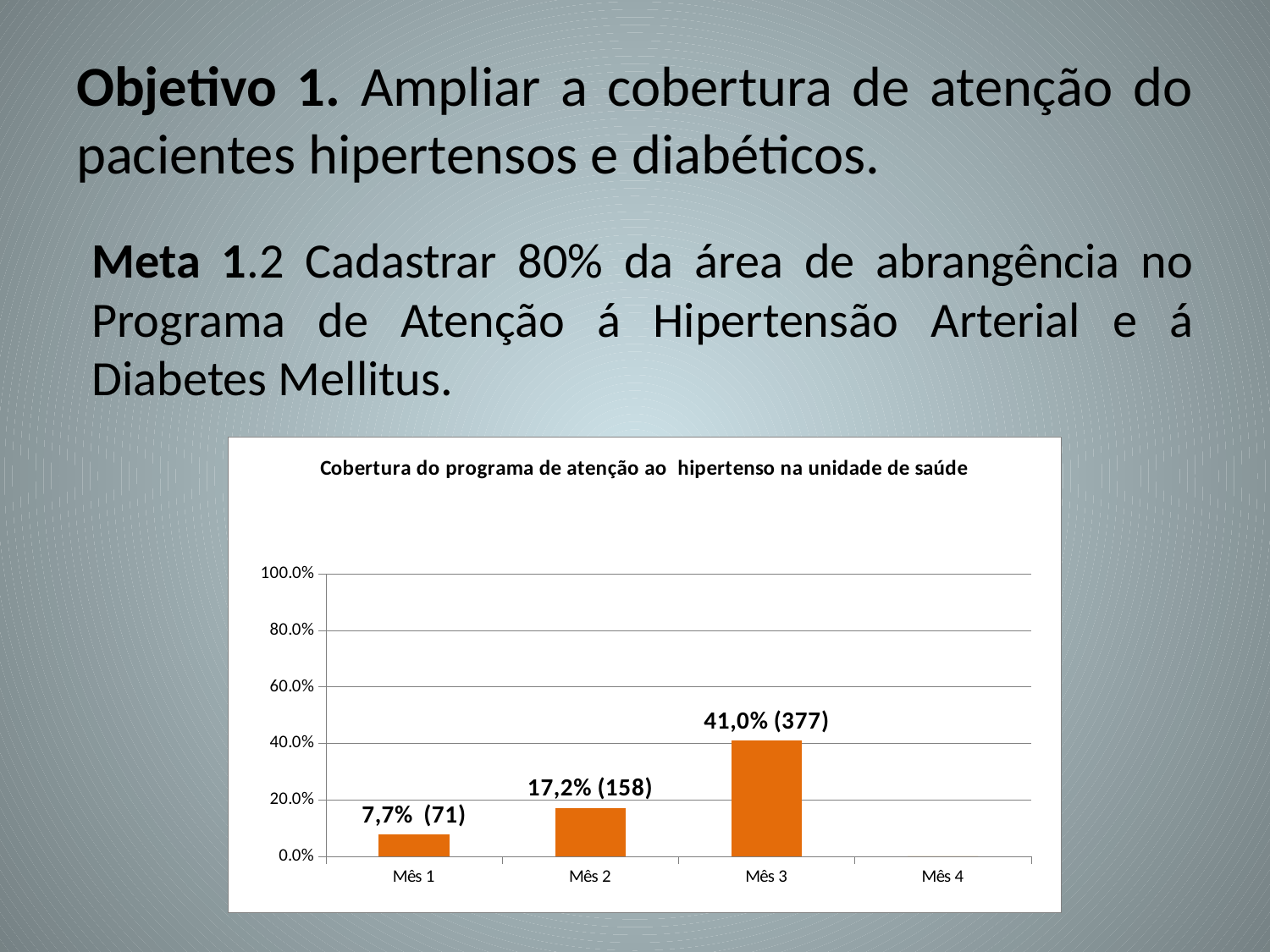
Which is larger, the value for Mês 2 or the value for Mês 1? Mês 2 Which month has the highest coverage in the chart? Mês 3 Do the values rise or fall from Mês 1 to Mês 3? rise What is the value shown for Mês 2? 17,2% (158) What kind of chart is shown on the slide? bar chart What is the value shown for Mês 1? 7,7% (71) How many month categories are shown on the x axis? 4 How many more patients are counted in Mês 3 than in Mês 2? 219 What is the difference in percentage points between Mês 3 and Mês 2? 23,8 Is the value for Mês 3 greater or less than 60.0%? less What is the value shown for Mês 3? 41,0% (377) Among the months with a plotted bar, which has the lowest coverage? Mês 1